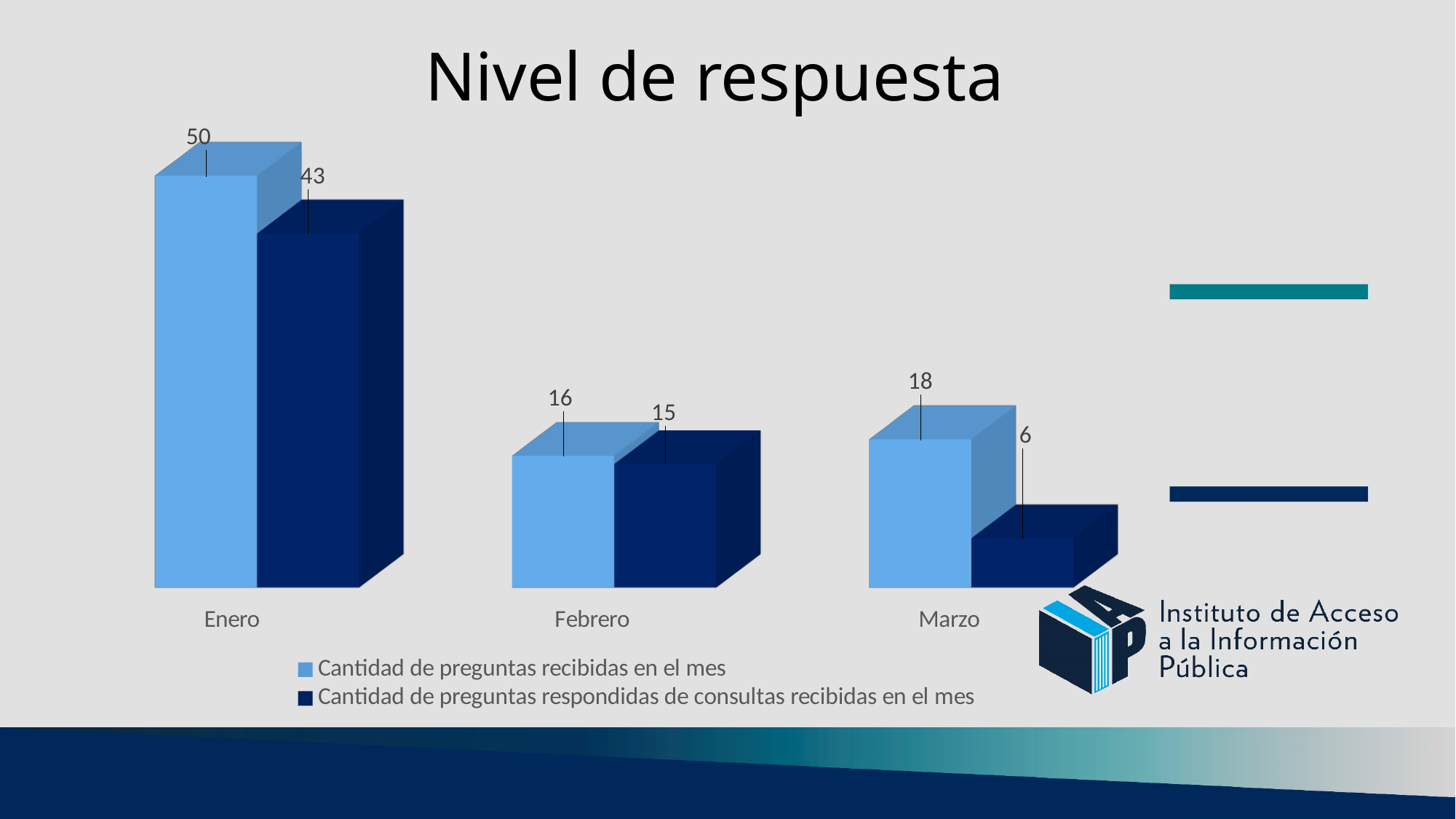
How many months are shown on the x axis? 3 What is the difference between the questions received and the questions answered in Marzo? 12 Which month has the highest value for 'Cantidad de preguntas recibidas en el mes'? Enero Which is larger: the questions received in Febrero or the questions received in Marzo? Marzo What kind of chart is shown on the slide? Bar chart What is the difference between the questions received and the questions answered in Enero? 7 What is the value of 'Cantidad de preguntas recibidas en el mes' for Enero? 50 Which month has the lowest value for 'Cantidad de preguntas respondidas de consultas recibidas en el mes'? Marzo What is the value of 'Cantidad de preguntas respondidas de consultas recibidas en el mes' for Febrero? 15 How many series does the legend list? 2 What is the title of the chart? Nivel de respuesta What is the value of 'Cantidad de preguntas respondidas de consultas recibidas en el mes' for Marzo? 6